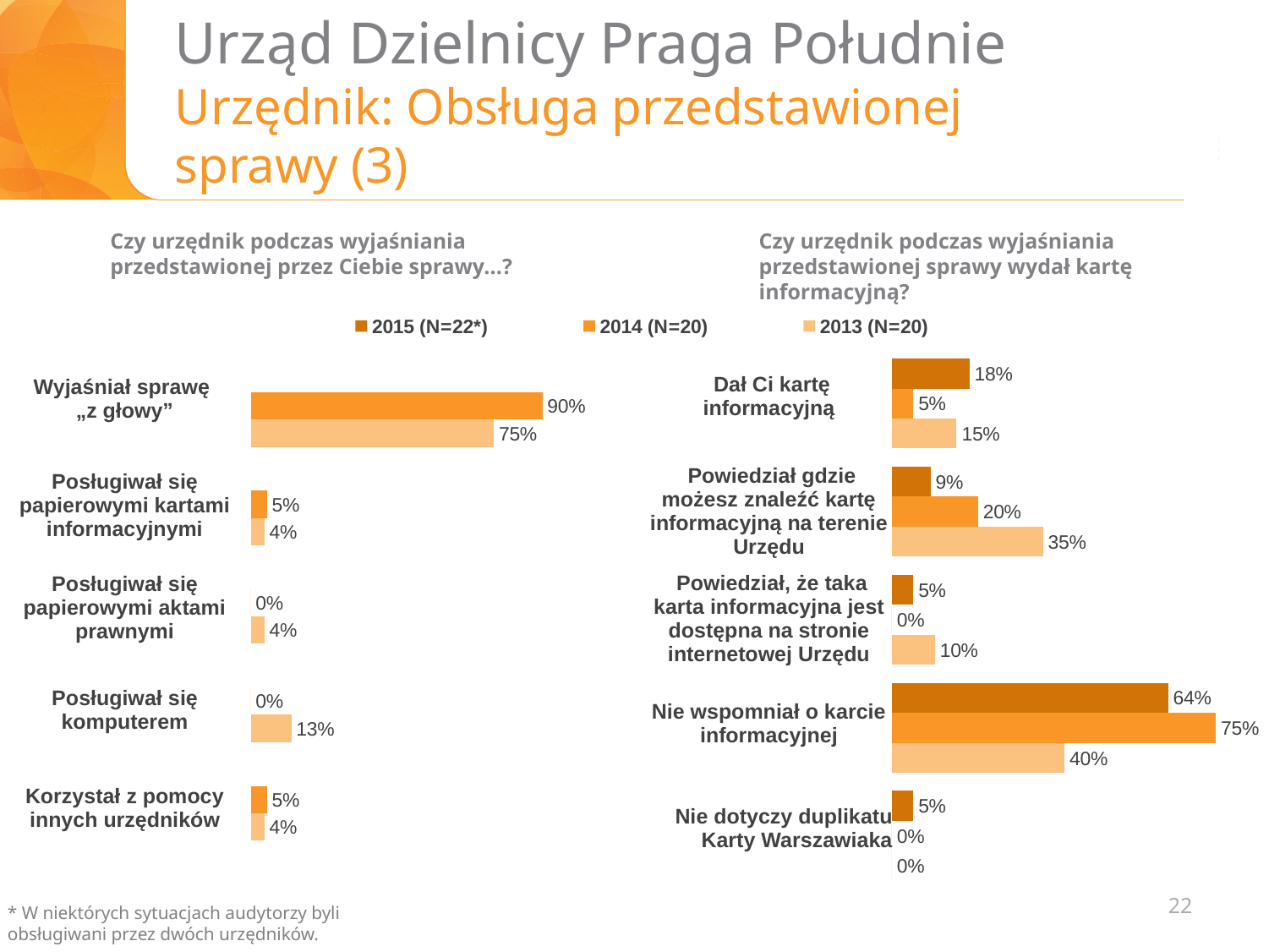
What type of chart is used on the left side of the slide? Bar chart In the right chart, which category has the highest 2014 value? Nie wspomniał o karcie informacyjnej How many series does the legend on the slide list? 3 In the left chart, what is the value of the lighter (2013) bar for "Posługiwał się komputerem"? 13% In the right chart, what is the 2015 value for "Powiedział gdzie możesz znaleźć kartę informacyjną na terenie Urzędu"? 9% How many categories are shown in the right chart? 5 In the right chart ("Czy urzędnik podczas wyjaśniania przedstawionej sprawy wydał kartę informacyjną?"), what is the 2015 value for "Nie wspomniał o karcie informacyjnej"? 64% In the left chart ("Czy urzędnik podczas wyjaśniania przedstawionej przez Ciebie sprawy...?"), what is the highest value shown? 90% In the right chart, what is the difference between the 2014 and 2013 values for "Nie wspomniał o karcie informacyjnej"? 35 percentage points In the right chart, for "Dał Ci kartę informacyjną", which year has the larger value, 2015 or 2013? 2015 In the right chart, what is the 2014 value for "Dał Ci kartę informacyjną"? 5% In the right chart, what is the 2013 value for "Powiedział gdzie możesz znaleźć kartę informacyjną na terenie Urzędu"? 35%